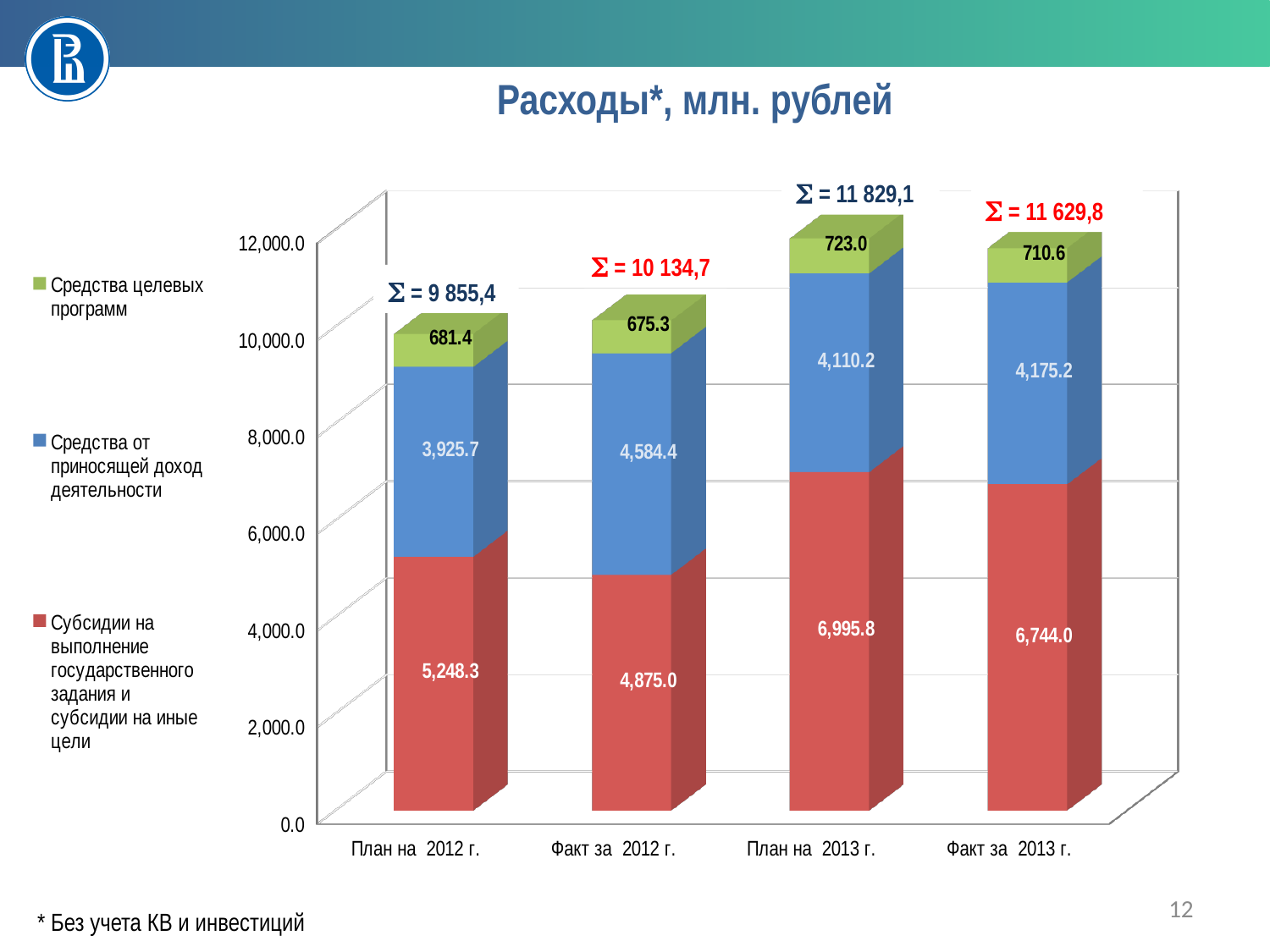
What kind of chart is shown on the slide? Stacked bar chart Which category has the lowest value for Средства целевых программ? Факт за 2012 г. Which category has the highest value for Субсидии на выполнение государственного задания и субсидии на иные цели? План на 2013 г. What is the value of Субсидии на выполнение государственного задания и субсидии на иные цели for План на 2012 г.? 5,248.3 What is the difference between the Средства от приносящей доход деятельности values for Факт за 2013 г. and План на 2013 г.? 65.0 How many series does the legend list? 3 What is the title of the chart? Расходы*, млн. рублей What is the value of Средства целевых программ for План на 2013 г.? 723.0 How many categories are shown on the x axis? 4 What is the value of Средства от приносящей доход деятельности for Факт за 2012 г.? 4,584.4 Which is larger: Субсидии на выполнение государственного задания for Факт за 2012 г. or for Факт за 2013 г.? Факт за 2013 г. What is the total (Σ) shown above the bar for Факт за 2013 г.? 11 629,8